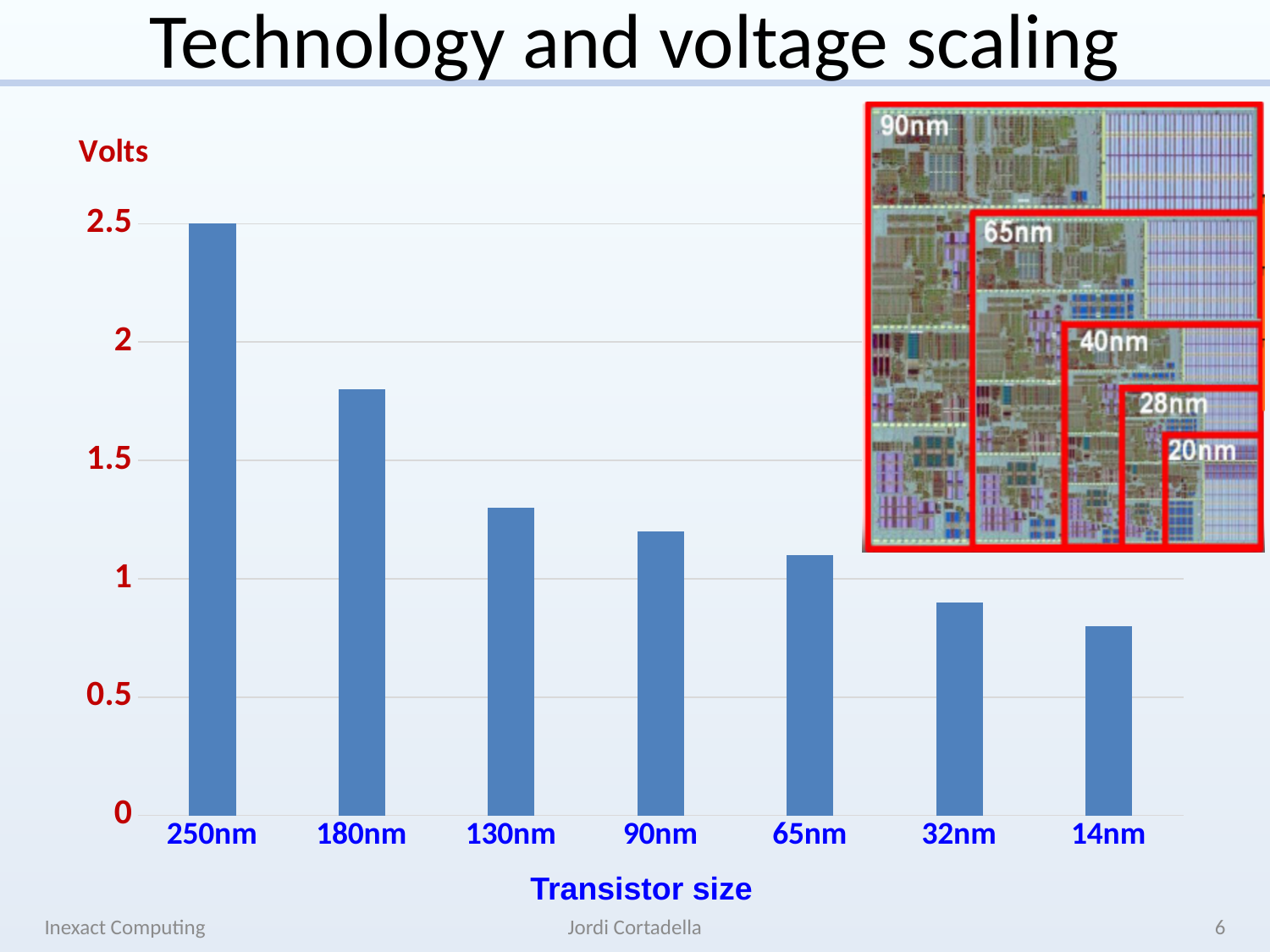
Which transistor size has the lowest voltage? 14nm What is the label on the x axis of the chart? Transistor size Which has a higher voltage, 180nm or 90nm? 180nm Is the value for 130nm greater or less than 1.5? less What kind of chart is shown on the slide? bar chart Which transistor size has the highest voltage? 250nm How many transistor sizes are plotted on the x axis? 7 Is the value for 32nm greater or less than 1? less Is the value for 65nm greater or less than 1? greater Do the voltages rise or fall as you move from 250nm to 14nm along the x axis? fall What is the voltage for 250nm? 2.5